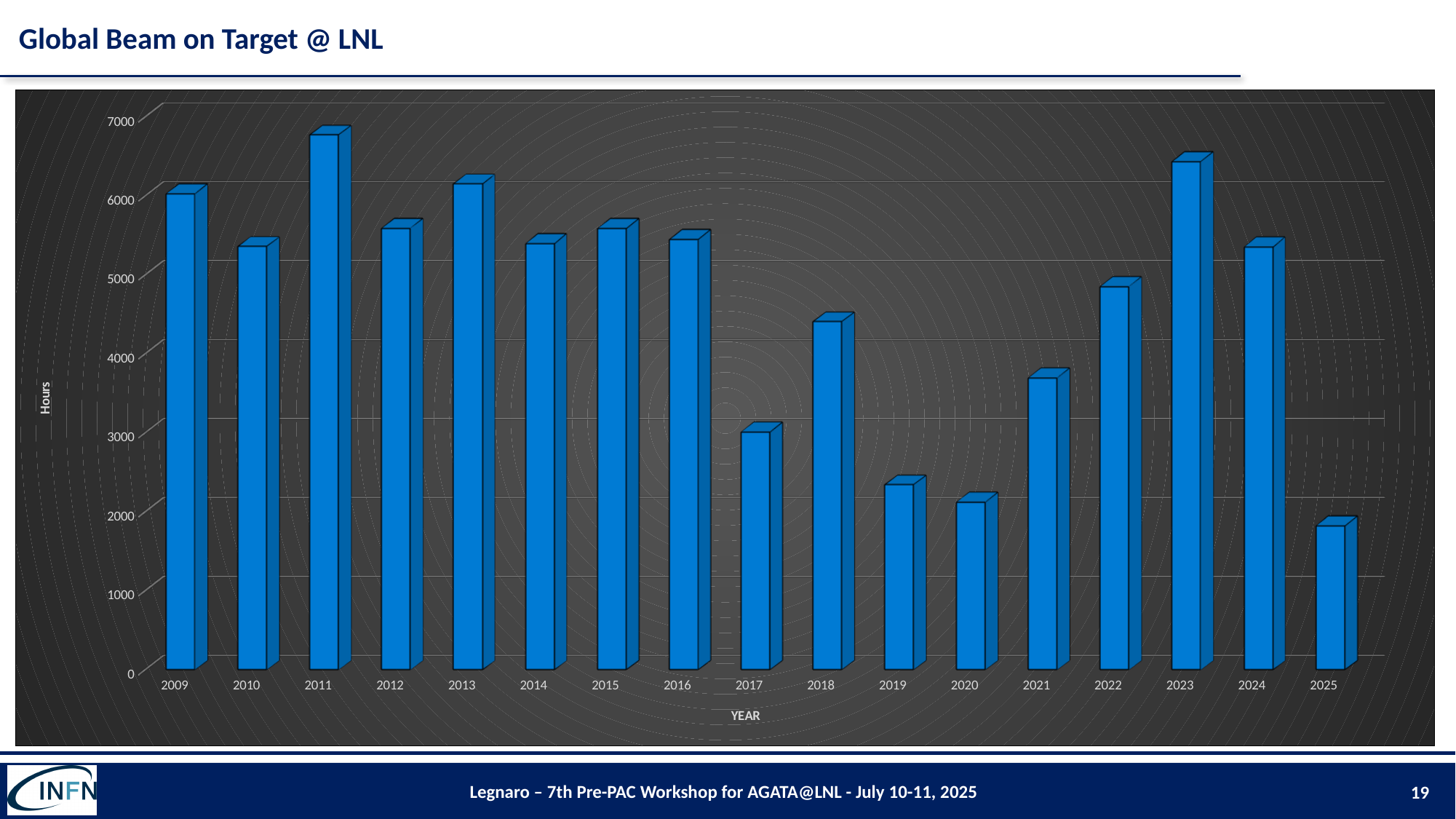
Is the value for 2021 greater or less than 4000? less Is the value for 2023 greater or less than 6000? greater How many years are plotted on the x axis of the chart? 17 Which year has the highest number of hours in the chart? 2011 What is the label of the vertical axis of the chart? Hours Is the value for 2025 greater or less than 2000? less What kind of chart is shown on the slide? bar chart Which year has more hours, 2019 or 2025? 2019 Which year has more hours, 2018 or 2021? 2018 Which year has the lowest number of hours in the chart? 2025